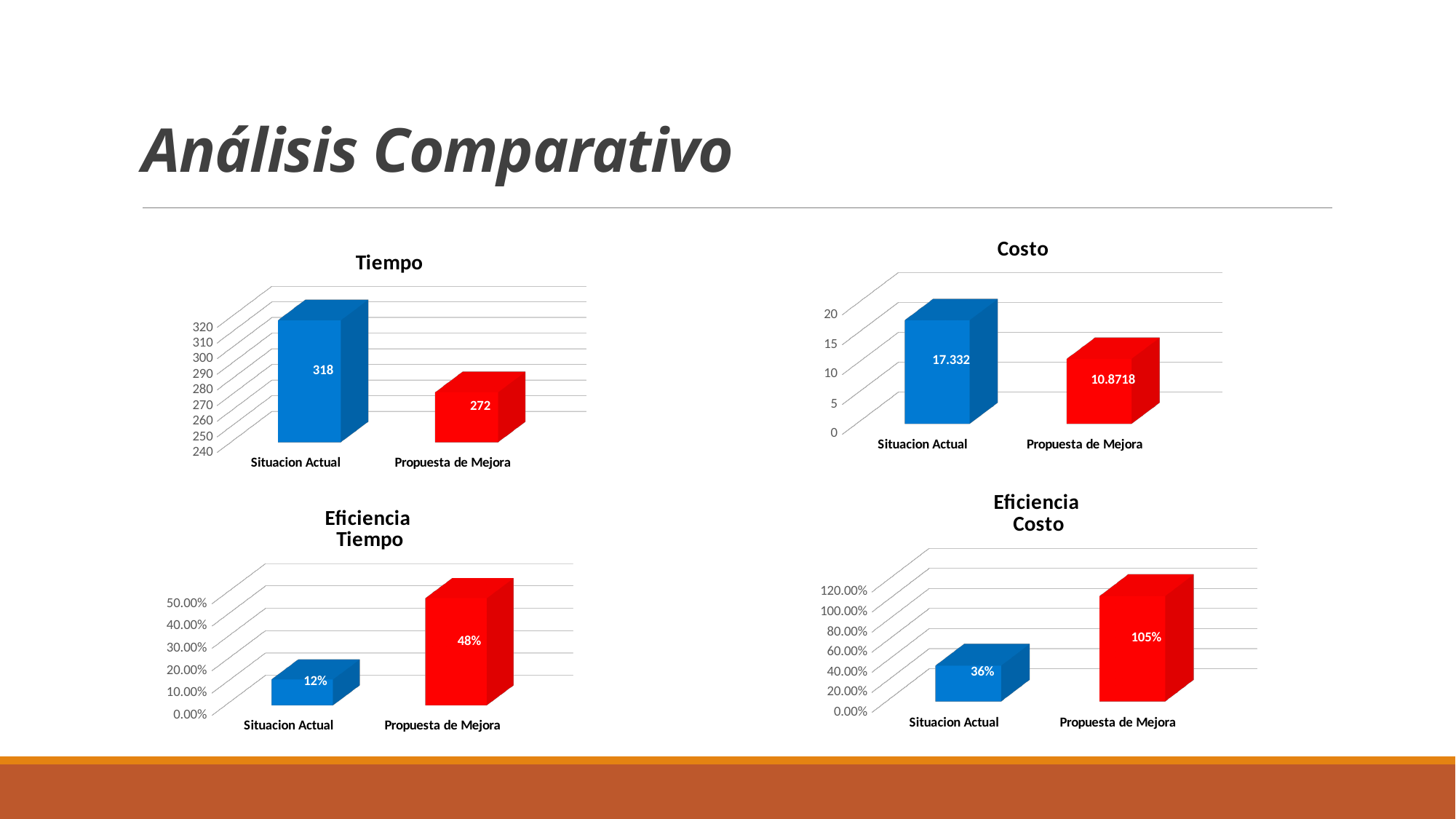
What kind of chart is the 'Tiempo' chart? Bar chart In the 'Tiempo' chart, what is the difference between Situacion Actual and Propuesta de Mejora? 46 In the 'Tiempo' chart, what is the value for Situacion Actual? 318 In the 'Eficiencia Costo' chart, is the value for Propuesta de Mejora greater or less than 100.00%? greater In the 'Eficiencia Costo' chart, what is the value for Situacion Actual? 36% In the 'Eficiencia Costo' chart, which is larger, Situacion Actual or Propuesta de Mejora? Propuesta de Mejora In the 'Costo' chart, what is the value for Situacion Actual? 17.332 In the 'Tiempo' chart, what is the value for Propuesta de Mejora? 272 In the 'Costo' chart, what is the value for Propuesta de Mejora? 10.8718 In the 'Eficiencia Tiempo' chart, what is the value for Propuesta de Mejora? 48% In the 'Eficiencia Tiempo' chart, which category has the highest value? Propuesta de Mejora In the 'Costo' chart, which category has the lowest value? Propuesta de Mejora